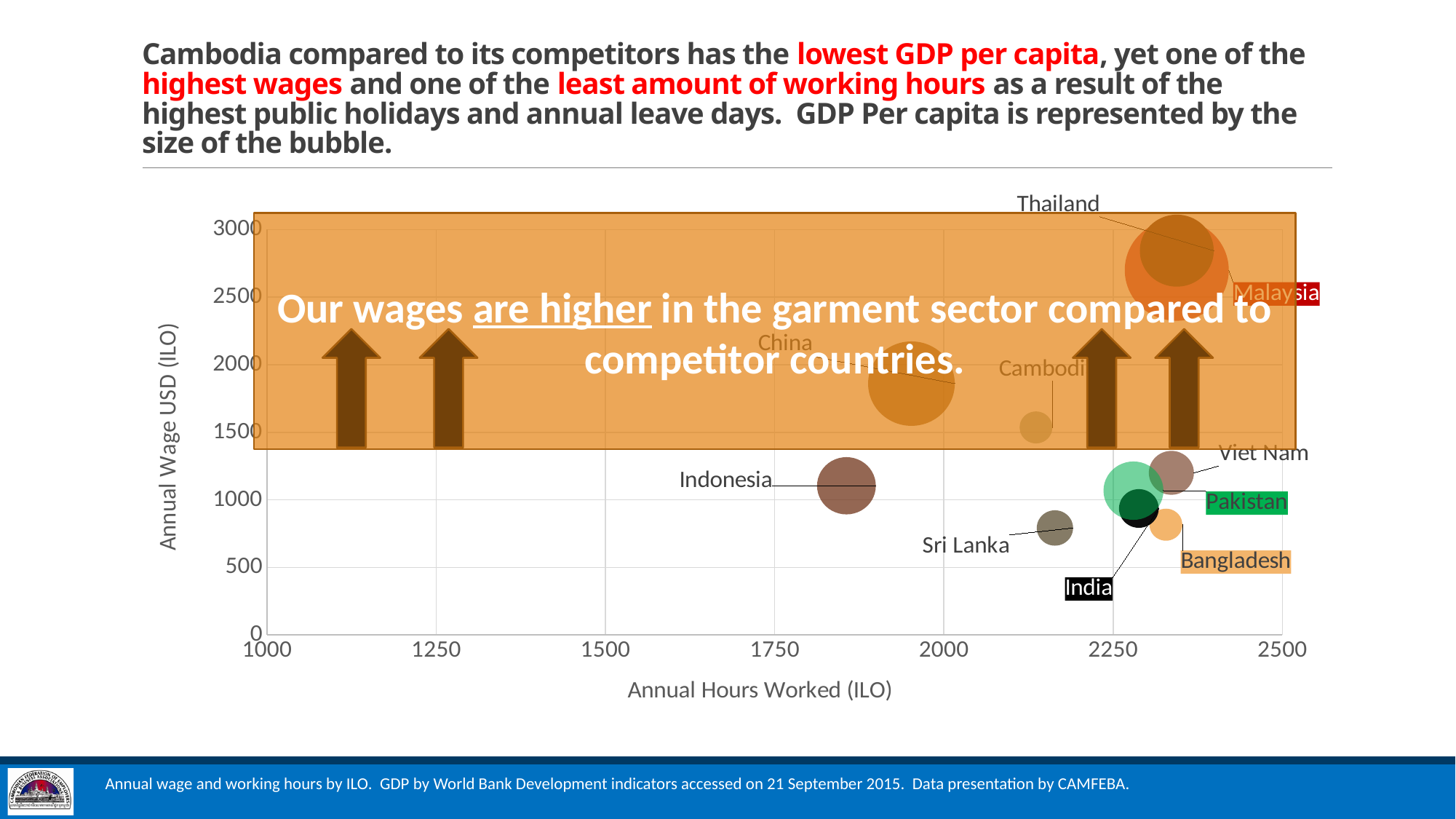
What is the title of the vertical axis? Annual Wage USD (ILO) What kind of chart is shown on the slide? Bubble chart What is the title of the horizontal axis? Annual Hours Worked (ILO) Which has a higher annual wage, China or Indonesia? China Which has a higher annual wage, Thailand or Cambodia? Thailand Which country has the highest annual wage on the chart? Thailand Is the annual wage for Thailand greater or less than 2500? greater Are the annual hours worked for Indonesia greater or less than 2000? less Is the annual wage for Indonesia greater or less than 1000? greater Which country has the lowest annual hours worked on the chart? Indonesia How many countries are plotted on the chart? 10